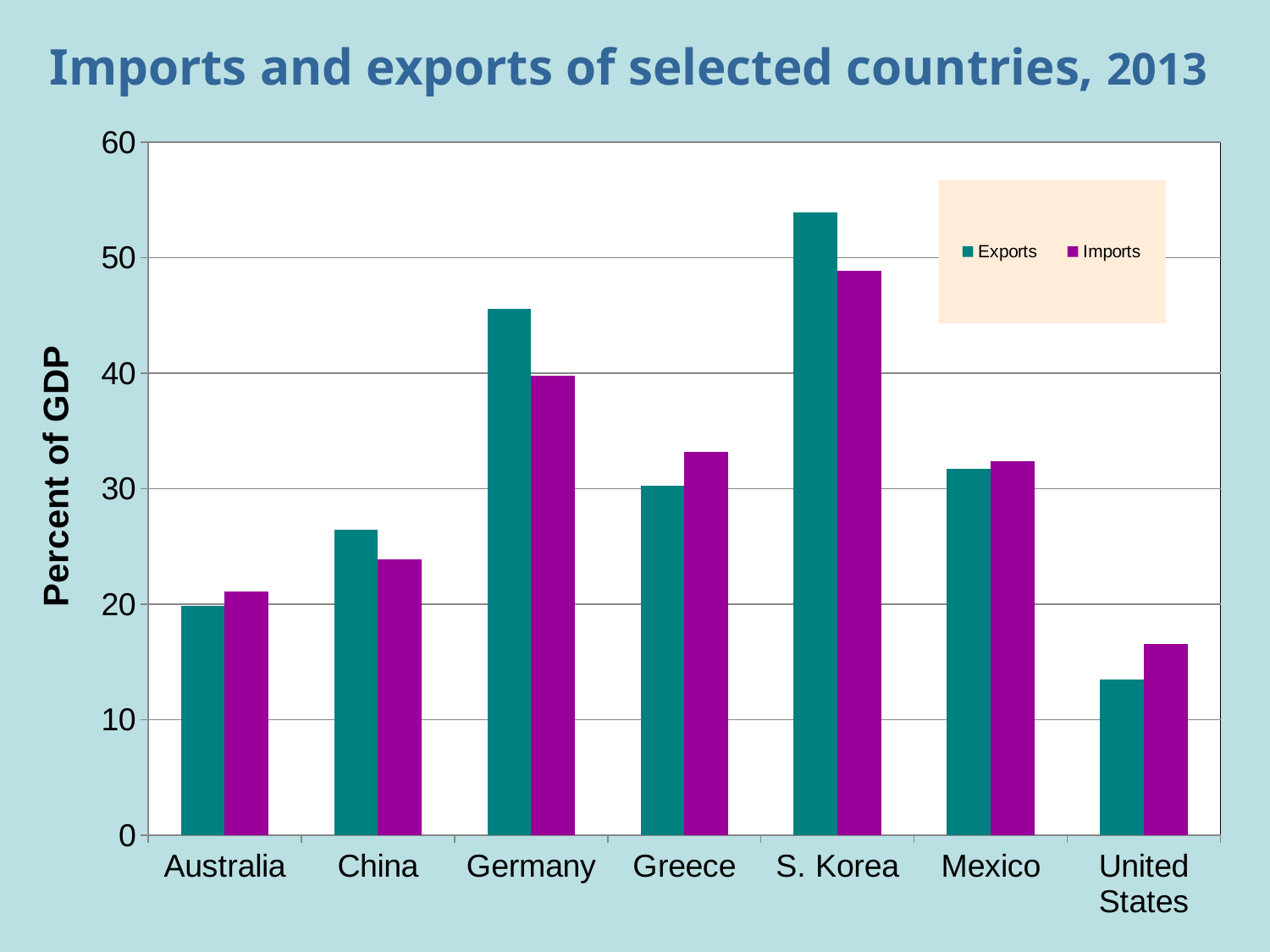
How many countries are shown on the x axis? 7 Is the Imports value for China greater or less than 30? less Is the Exports value for Germany greater or less than 40? greater For Germany, which is larger, Exports or Imports? Exports Is the Exports value for S. Korea greater or less than 50? greater What kind of chart is shown on the slide? bar chart What is the label on the y axis? Percent of GDP Which country has the lowest Exports value? United States Which country has the highest Imports value? S. Korea Which country has the highest Exports value? S. Korea How many series does the legend list? 2